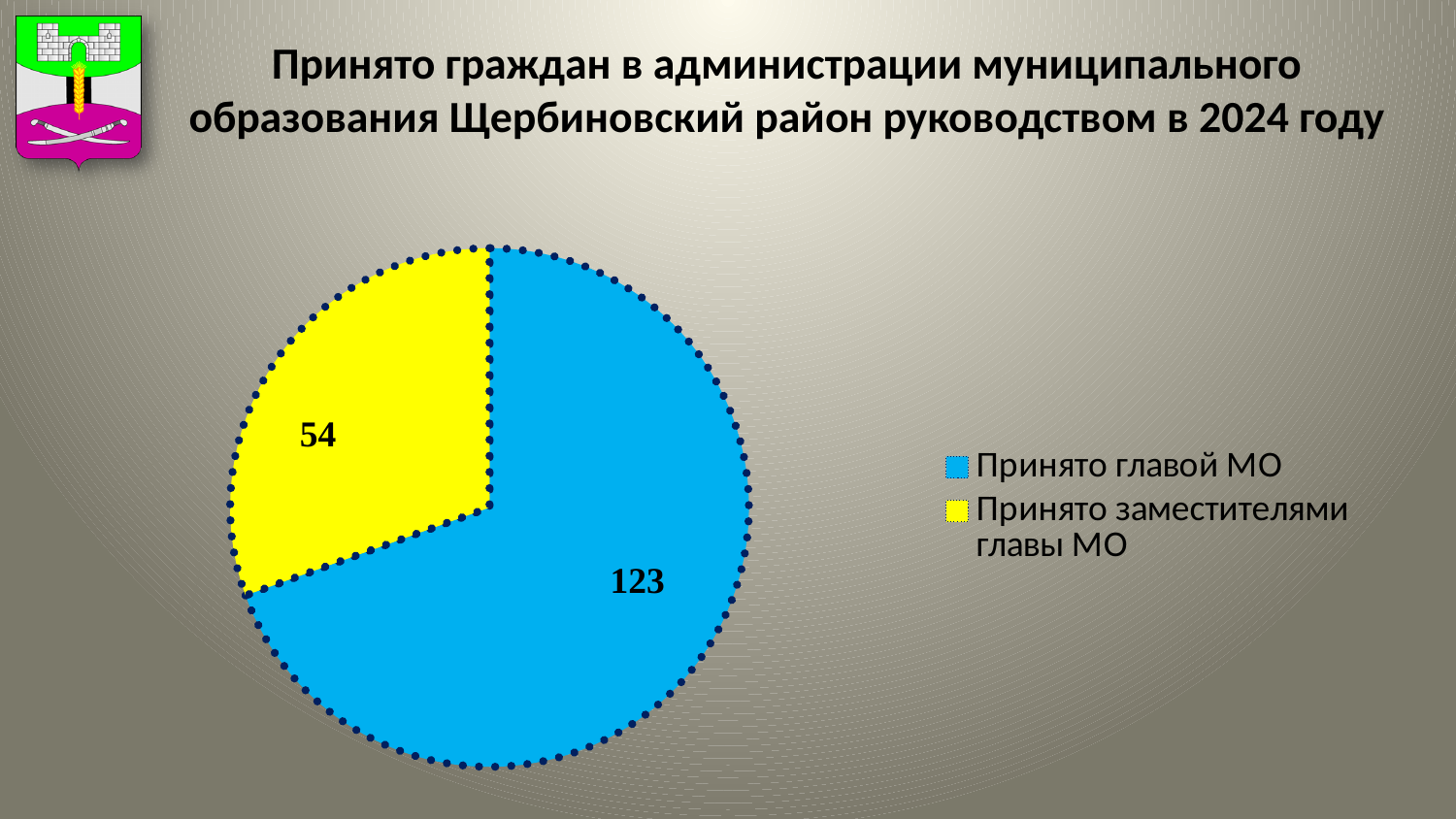
How many entries does the legend list? 2 What is the total number of citizens received across both slices? 177 How many citizens were received by the deputy heads (Принято заместителями главы МО)? 54 How many slices does the pie chart have? 2 Which category has the smallest slice of the pie? Принято заместителями главы МО Which category has the largest slice of the pie? Принято главой МО What is the difference between the number received by the head of the municipality and the number received by the deputy heads? 69 Which colour represents Принято заместителями главы МО in the chart? yellow What kind of chart is shown on the slide? pie chart How many citizens were received by the head of the municipality (Принято главой МО)? 123 What share of the pie does the slice for Принято главой МО represent, to the nearest whole percent? 69% Which is larger: the number received by the head of the municipality or by the deputy heads? Принято главой МО